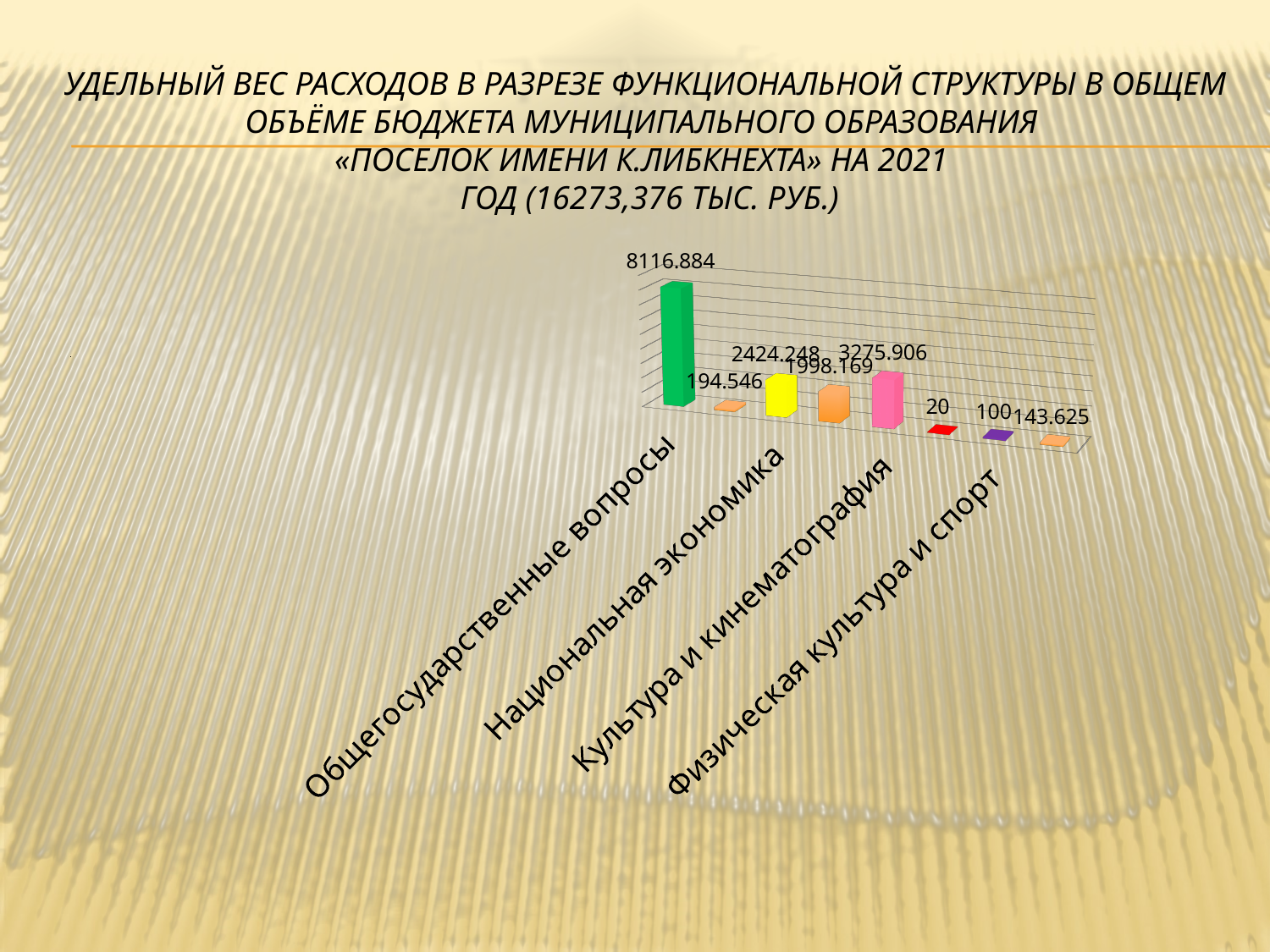
What is the difference between the highest value (8116.884) and the value 3275.906? 4840.978 What is the difference between the bars labelled 143.625 and 100? 43.625 Which is larger: the yellow bar labelled 2424.248 or the orange bar labelled 1998.169? 2424.248 What is the value of the last bar on the right? 143.625 What is the value of the second bar from the left? 194.546 What kind of chart is shown on the slide? bar chart Which category has the highest value in the chart? Общегосударственные вопросы What is the value of the pink bar (fifth from the left)? 3275.906 How many bars are plotted in the chart? 8 What is the smallest data label shown in the chart? 20 According to the slide title, what is the total budget volume for 2021? 16273,376 тыс. руб. What is the value shown for Общегосударственные вопросы? 8116.884